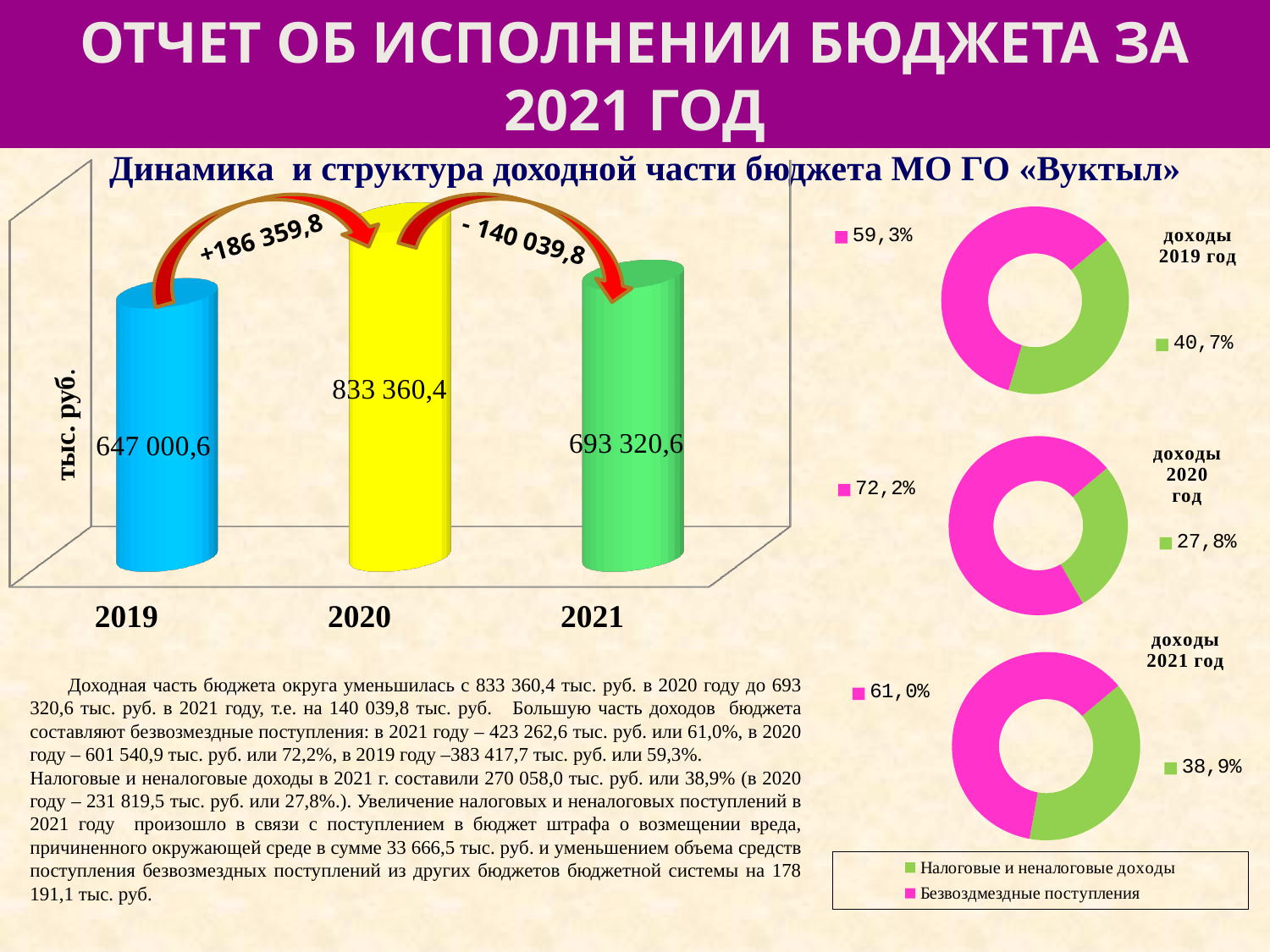
In the bar chart on the left, what is the value for 2019? 647 000,6 In the bar chart on the left, which year has the highest value? 2020 In the bar chart on the left, what is the value for 2020? 833 360,4 How many entries does the legend below the donut charts list? 2 What type of chart is the chart on the left showing values for 2019, 2020 and 2021? bar chart How many years (categories) are shown in the bar chart on the left? 3 In the bar chart on the left, which is larger: the value for 2021 or the value for 2019? 2021 In the bar chart on the left, which year has the lowest value? 2019 In the donut chart titled 'доходы 2021 год', what share is shown for Налоговые и неналоговые доходы? 38,9% In the bar chart on the left, what is the difference between the 2020 and 2021 values? 140 039,8 In the donut chart titled 'доходы 2020 год', what share is shown for Безвоздмездные поступления? 72,2% In the donut chart titled 'доходы 2019 год', what share is shown for Налоговые и неналоговые доходы? 40,7%